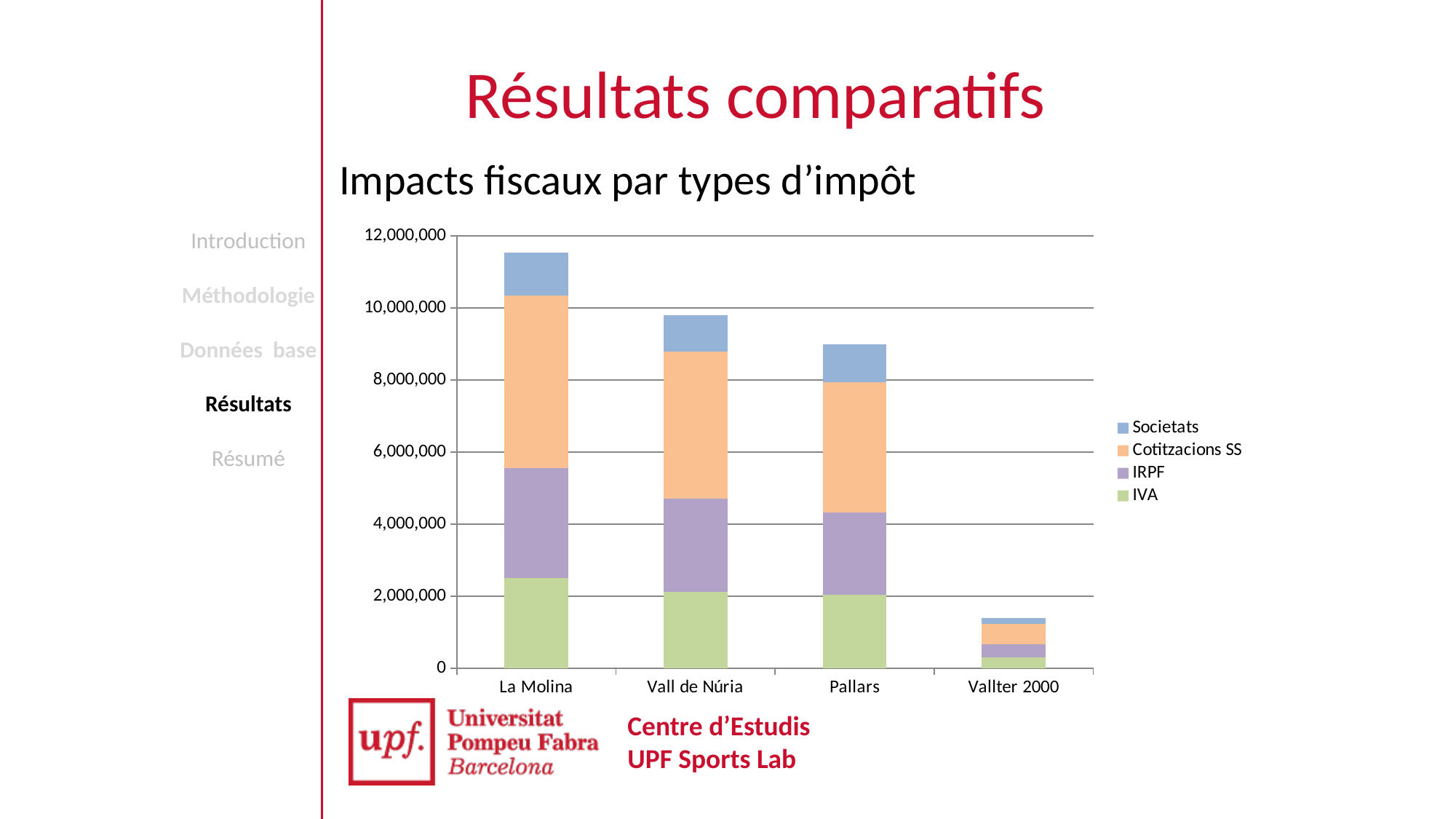
What kind of chart is shown on the slide? Stacked bar chart Which series is shown in green in the legend? IVA Is the total value for Vallter 2000 greater or less than 2,000,000? less Which has a larger total stacked bar, La Molina or Pallars? La Molina Which category has the lowest total stacked bar? Vallter 2000 Is the total value for Vall de Núria greater or less than 8,000,000? greater Which category has the highest total stacked bar? La Molina Do the total bar heights rise or fall from left to right along the x axis? fall How many categories (ski resorts) are shown on the x axis? 4 How many series does the legend list? 4 Is the total value for La Molina greater or less than 10,000,000? greater